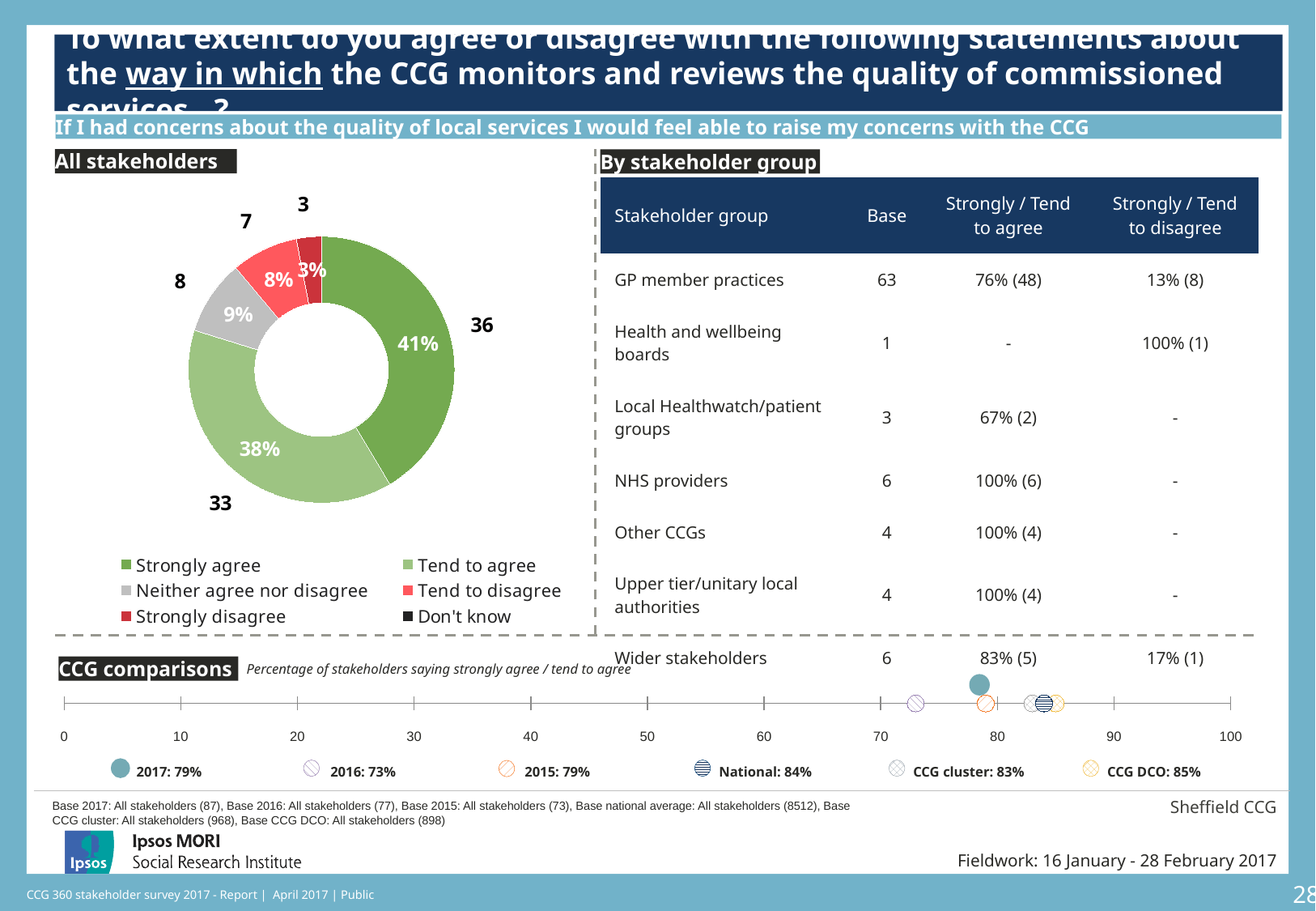
In the 'CCG comparisons' chart, which marker has the lowest value? 2016: 73% In the 'CCG comparisons' chart, what is the difference between the CCG DCO value and the 2017 value? 6 percentage points In the 'All stakeholders' donut chart, what is the difference in percentage points between 'Tend to agree' and 'Tend to disagree'? 30 In the 'All stakeholders' donut chart, which labelled response category has the smallest share? Strongly disagree In the 'All stakeholders' donut chart, which response category has the largest share? Strongly agree In the 'All stakeholders' donut chart, what percentage of stakeholders strongly agree? 41% In the 'All stakeholders' donut chart, what percentage of stakeholders tend to agree? 38% In the 'All stakeholders' donut chart, which is larger: the share for 'Neither agree nor disagree' or the share for 'Tend to disagree'? Neither agree nor disagree How many entries does the legend of the 'All stakeholders' chart list? 6 In the 'All stakeholders' donut chart, how many stakeholders neither agree nor disagree? 8 In the 'CCG comparisons' chart, what is the 2017 percentage of stakeholders saying strongly agree / tend to agree? 79% What type of chart is the 'All stakeholders' chart? Donut chart